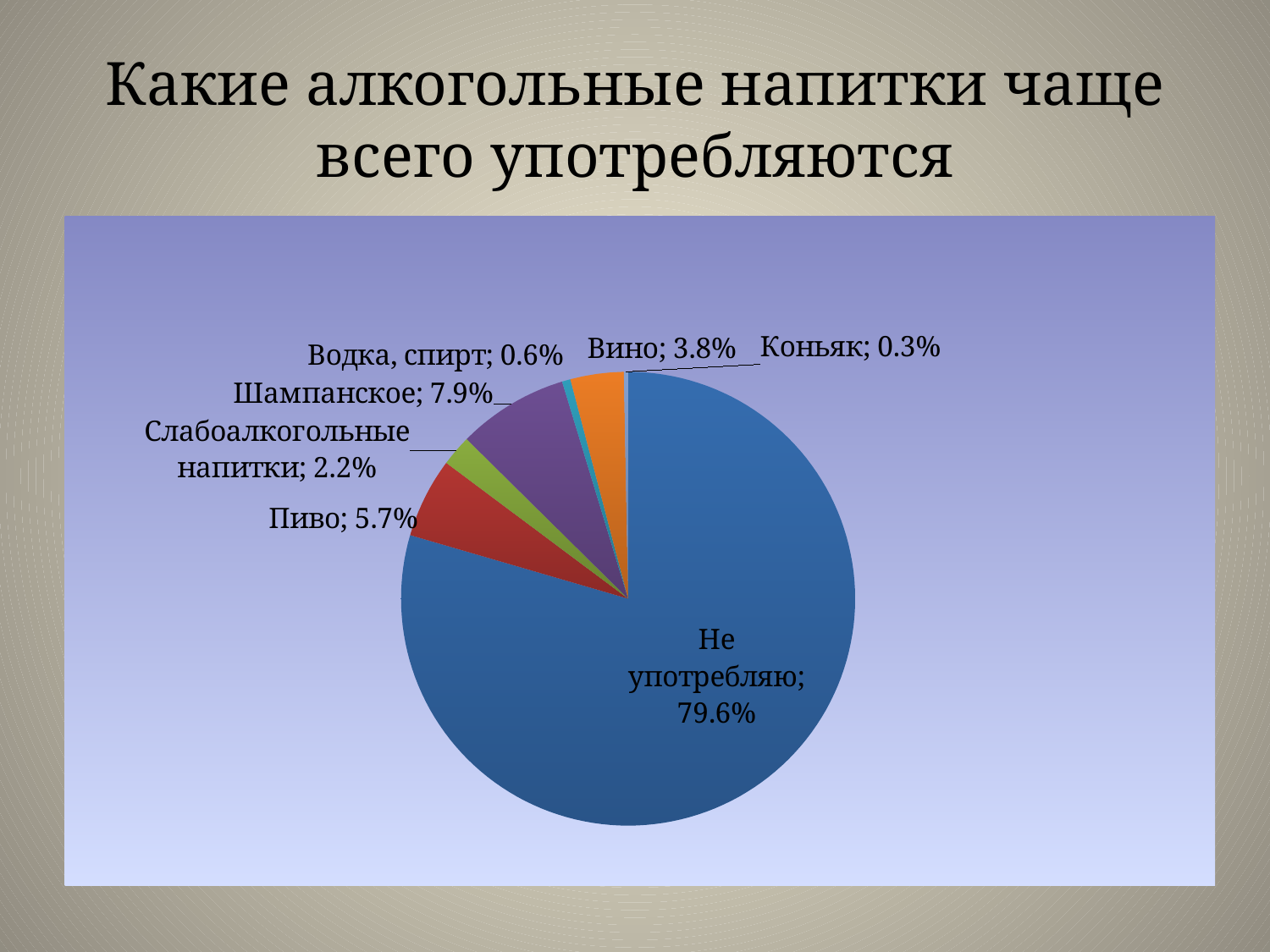
What is the value shown for "Шампанское"? 7.9% How many slices does the pie chart have? 7 What share of the pie is labelled "Не употребляю"? 79.6% Which category has the largest slice of the pie? Не употребляю Which is larger, the value for "Вино" or the value for "Пиво"? Пиво What is the value shown for "Слабоалкогольные напитки"? 2.2% What is the value shown for "Коньяк"? 0.3% What is the value shown for "Пиво"? 5.7% Which category has the smallest slice of the pie? Коньяк What kind of chart is shown on the slide? Pie chart What is the difference between the values for "Шампанское" and "Вино"? 4.1% What is the title of the slide containing the chart? Какие алкогольные напитки чаще всего употребляются